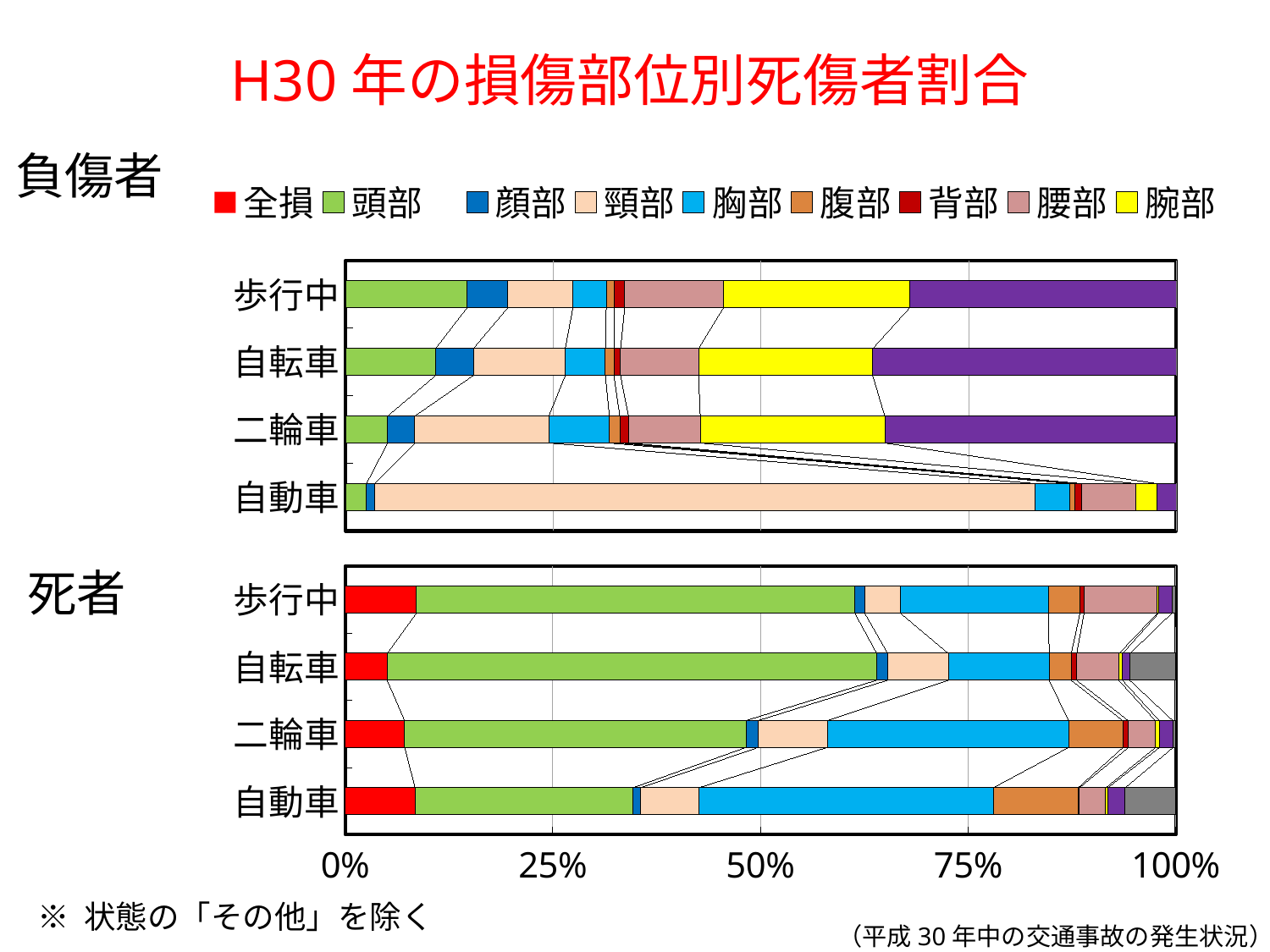
In the legend, which body part is shown in red? 全損 What kind of chart is used for the 負傷者 data on the slide? Stacked bar chart In the 死者 chart, is the 胸部 share for 自動車 greater or less than 50%? less In the 負傷者 chart, which category has the largest 頸部 share? 自動車 In the 負傷者 chart, is the 頭部 share for 歩行中 greater or less than 25%? less How many categories (road-user types) are shown on the y axis of the 死者 chart? 4 In the 死者 chart, which has the larger 頭部 share, 自転車 or 自動車? 自転車 What is the title of the slide's chart? H30 年の損傷部位別死傷者割合 In the 死者 chart, which category has the smallest 頭部 share? 自動車 How many series does the legend at the top of the slide list? 9 In the 負傷者 chart, is the 頸部 share for 自動車 greater or less than 75%? greater